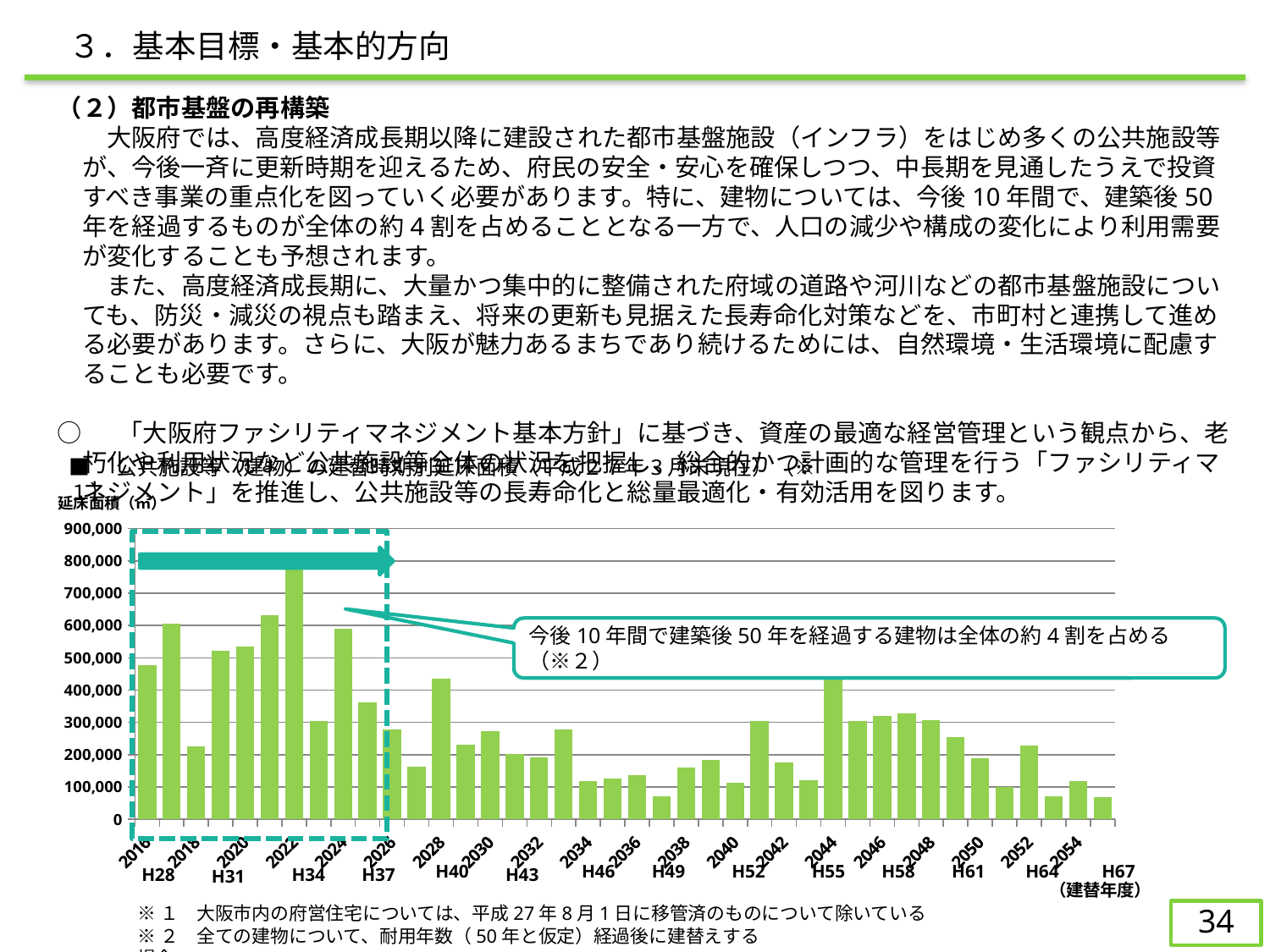
Is the floor area value for 2016 greater or less than 400,000? greater What label is shown at the right end of the horizontal axis of the chart? （建替年度） Is the floor area value for 2044 greater or less than 400,000? greater Is the floor area value for 2052 greater or less than 300,000? less Do the floor area values generally rise or fall from 2044 to 2055? fall Which has the larger floor area, 2024 or 2026? 2024 Which has the larger floor area, 2022 or 2044? 2022 Which rebuild year (建替年度) has the highest floor area (延床面積) in the chart? 2022 What kind of chart is shown on the slide? bar chart What is the highest value shown on the vertical axis of the chart? 900,000